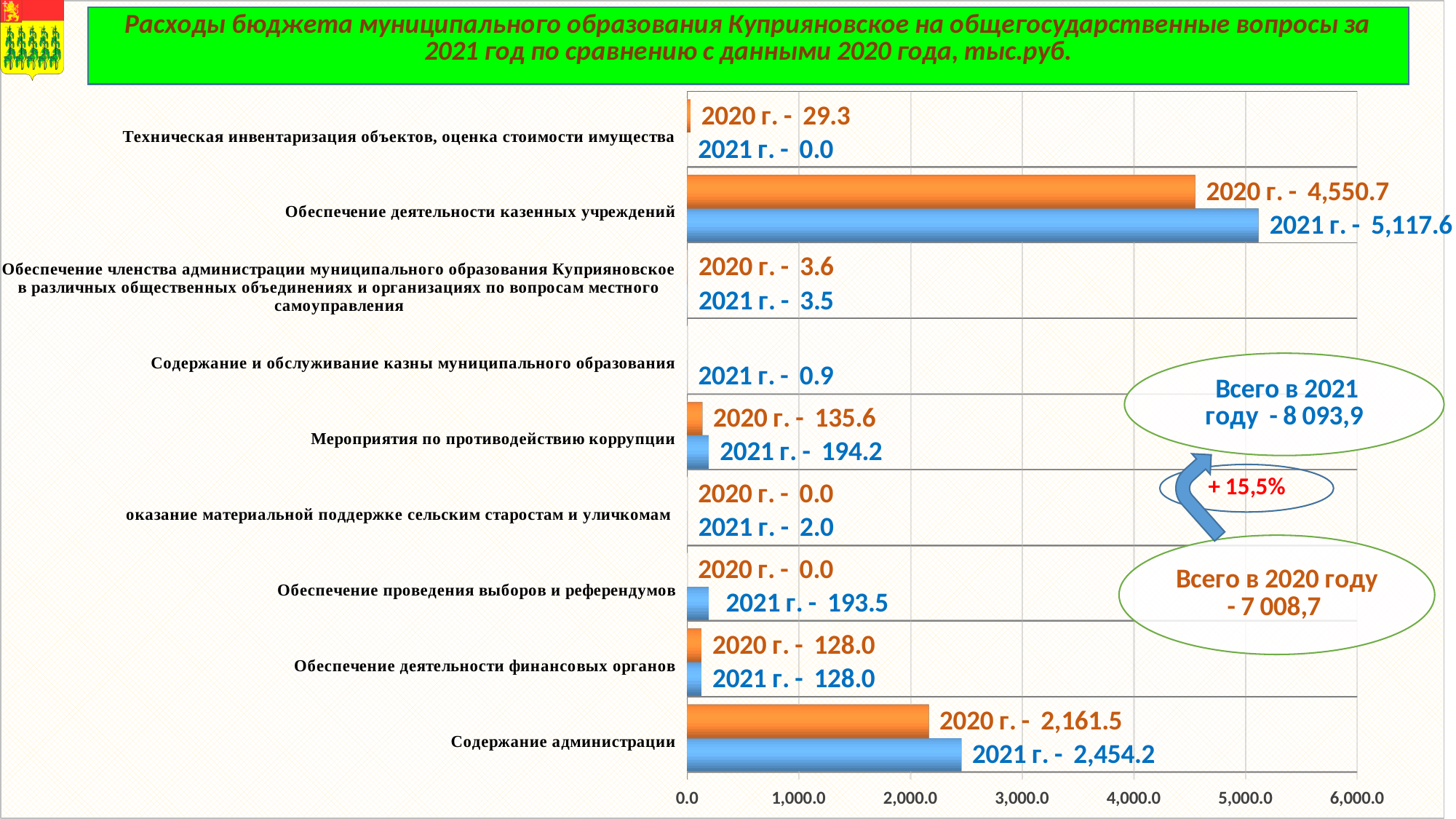
What is the difference between the 2021 and 2020 values for Содержание администрации? 292.7 Which category has the highest 2021 value? Обеспечение деятельности казенных учреждений Which is larger for Мероприятия по противодействию коррупции: the 2020 value or the 2021 value? 2021 Is the 2021 value for Содержание администрации greater or less than 2,000.0? greater What is the 2021 value for Мероприятия по противодействию коррупции? 194.2 What is the 2021 value for Обеспечение деятельности казенных учреждений? 5,117.6 What type of chart is shown on the slide? bar chart What is the difference between the 2021 and 2020 values for Обеспечение деятельности казенных учреждений? 566.9 How many expenditure categories are shown on the chart? 9 What is the 2020 value for Техническая инвентаризация объектов, оценка стоимости имущества? 29.3 What is the 2021 value for Обеспечение проведения выборов и референдумов? 193.5 What is the 2020 value for Содержание администрации? 2,161.5